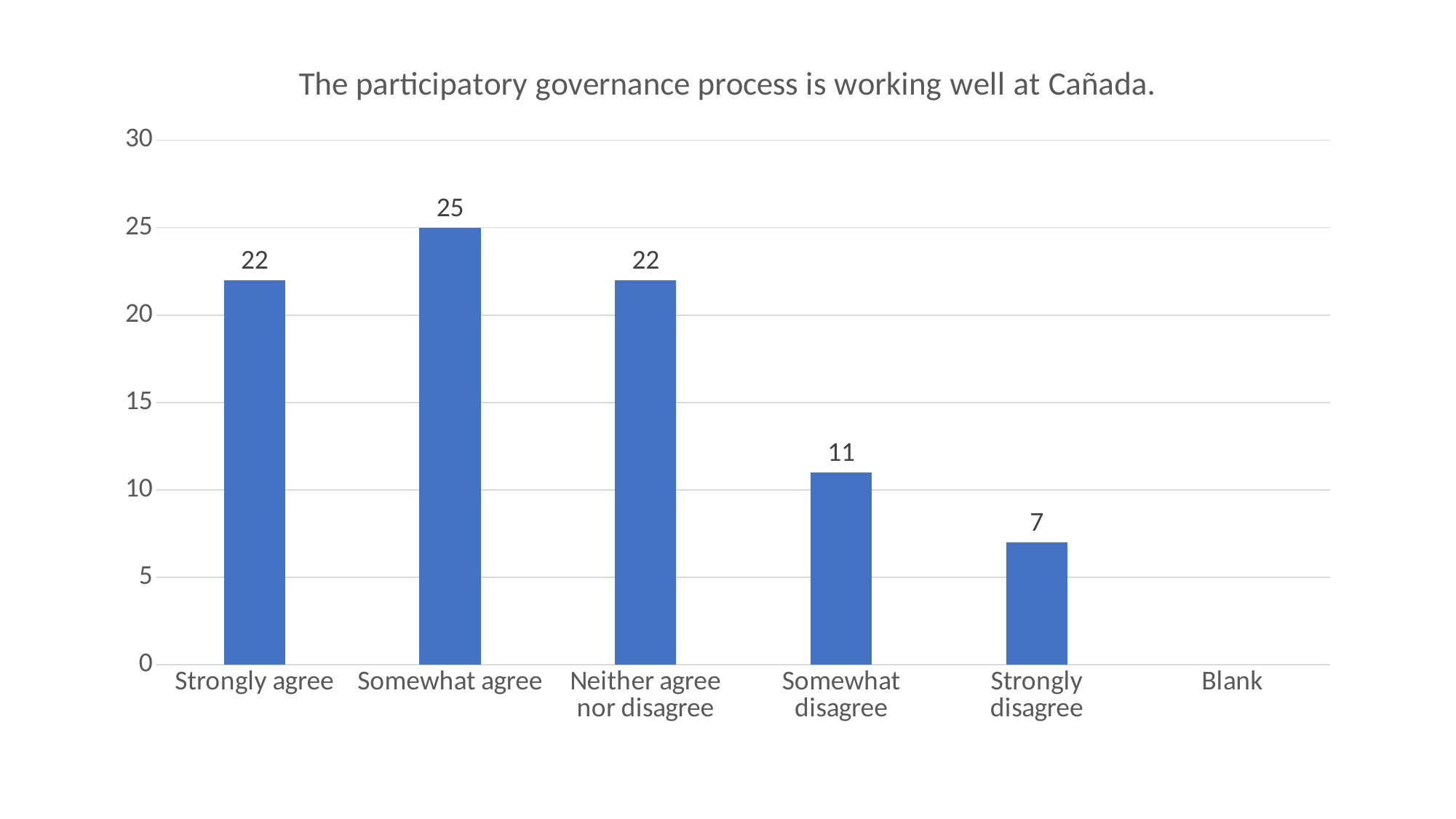
Which category has the highest value? Somewhat agree How many categories are shown on the x axis? 6 Which category with a visible bar has the lowest value? Strongly disagree What kind of chart is shown on the slide? bar chart What is the difference between the values for Somewhat agree and Strongly disagree? 18 Is the value for Somewhat disagree greater or less than 15? less What is the value for Somewhat agree? 25 What is the value for Somewhat disagree? 11 What is the title of the chart? The participatory governance process is working well at Cañada. What is the difference between the values for Strongly agree and Somewhat disagree? 11 Which is larger, the value for Somewhat agree or the value for Neither agree nor disagree? Somewhat agree What is the value for Strongly disagree? 7